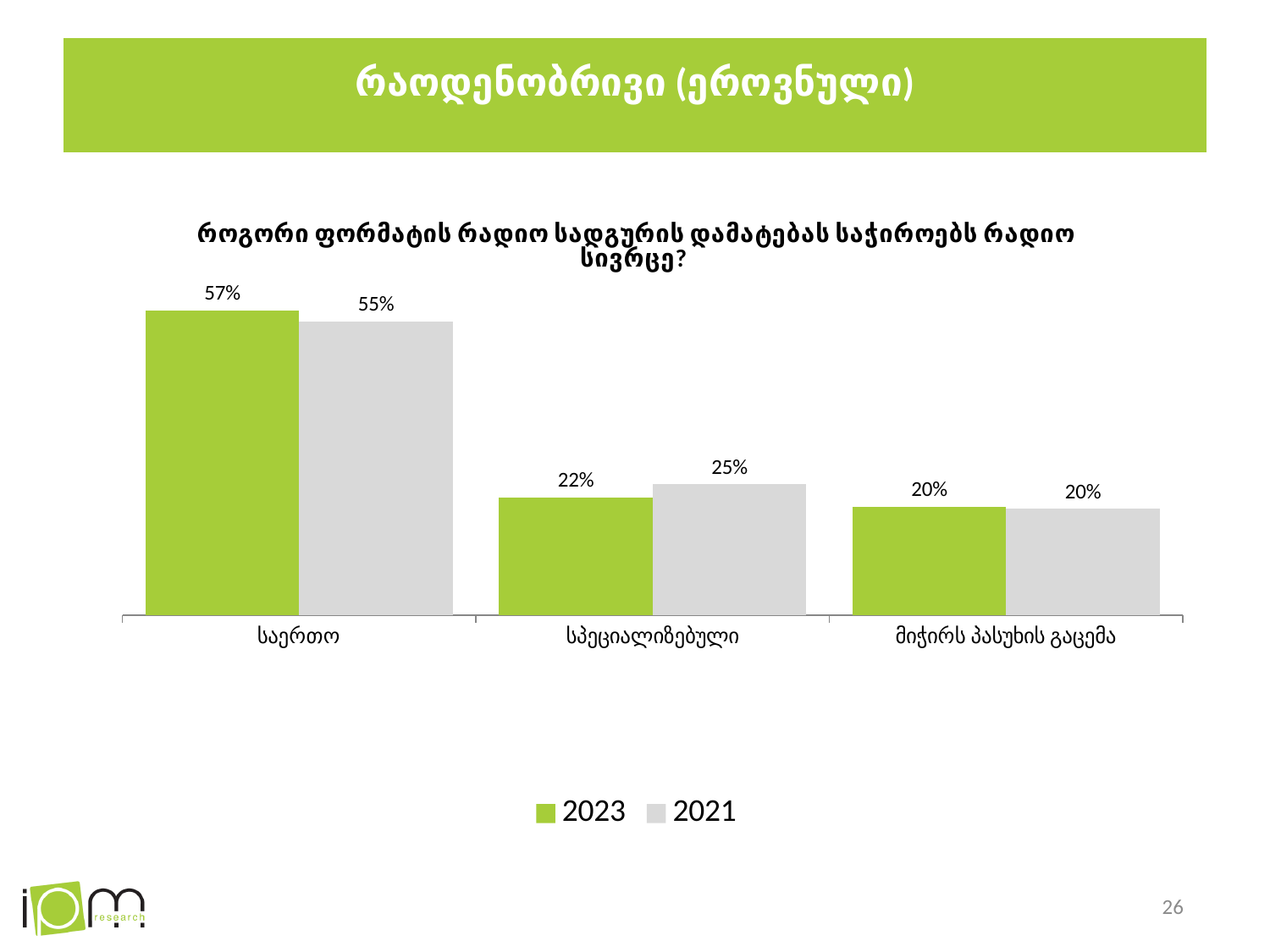
Which category has the lowest 2021 value? მიჭირს პასუხის გაცემა What is the difference between the 2021 and 2023 values for სპეციალიზებული? 3% Which category has the highest 2023 value? საერთო What is the 2021 value for სპეციალიზებული? 25% How many series does the legend list? 2 What kind of chart is shown on the slide? Bar chart What is the 2023 value for მიჭირს პასუხის გაცემა? 20% How many categories are shown on the x axis? 3 What is the 2023 value for საერთო? 57% What is the difference between the 2023 and 2021 values for საერთო? 2% Which series is shown in green? 2023 For სპეციალიზებული, which year has the larger value, 2023 or 2021? 2021